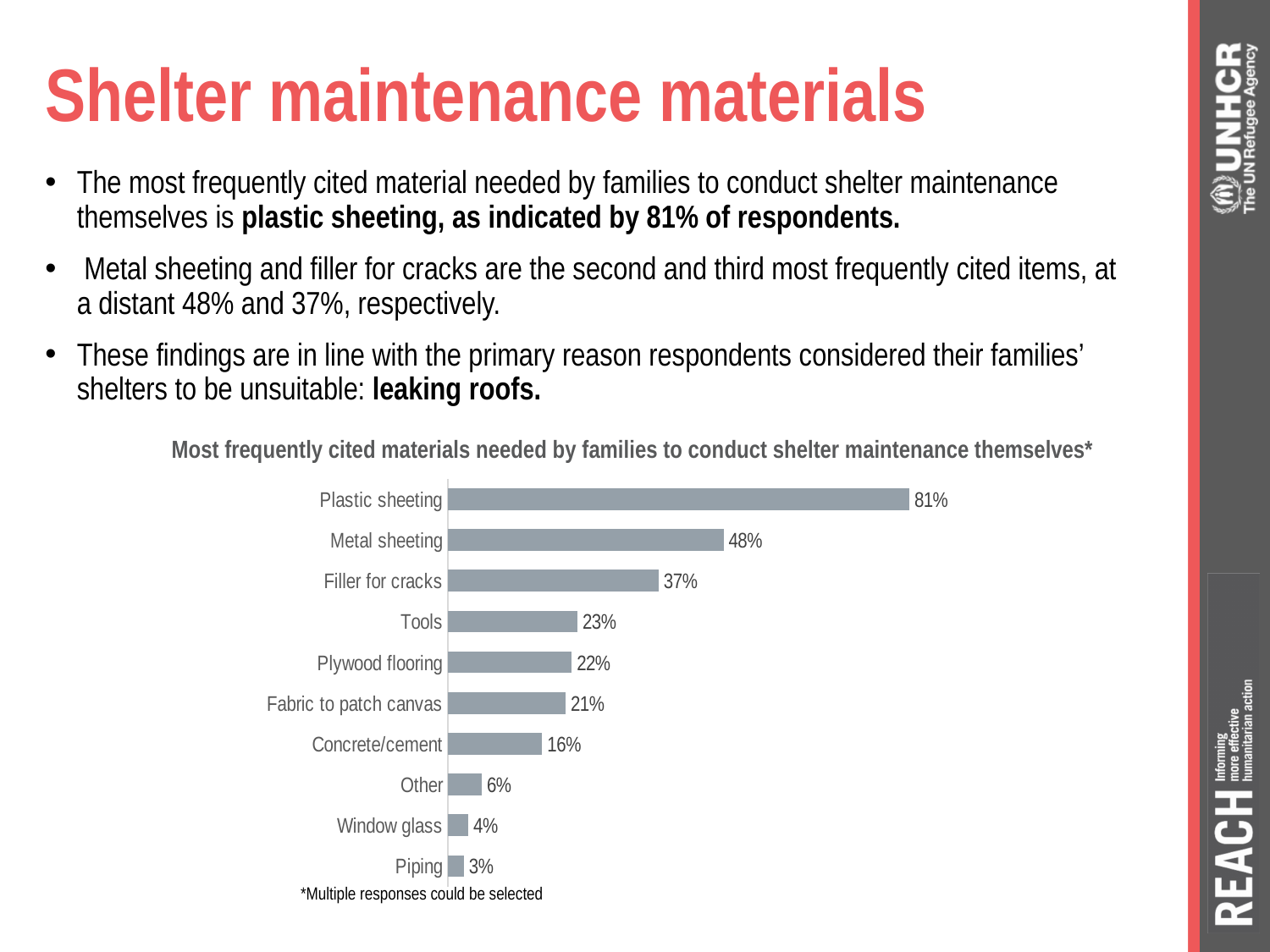
Which material has the lowest percentage in the chart? Piping What percentage of respondents cited plastic sheeting as a material needed for shelter maintenance? 81% What percentage is shown for Concrete/cement? 16% What is the value shown for Filler for cracks? 37% Which has a higher value, Metal sheeting or Filler for cracks? Metal sheeting What is the difference in percentage points between Plastic sheeting and Metal sheeting? 33 What is the title of the chart? Most frequently cited materials needed by families to conduct shelter maintenance themselves* How many materials are listed in the chart? 10 Which has a higher value, Window glass or Other? Other Which material has the highest percentage in the chart? Plastic sheeting What is the difference in percentage points between Tools and Plywood flooring? 1 What type of chart is shown on the slide? Bar chart